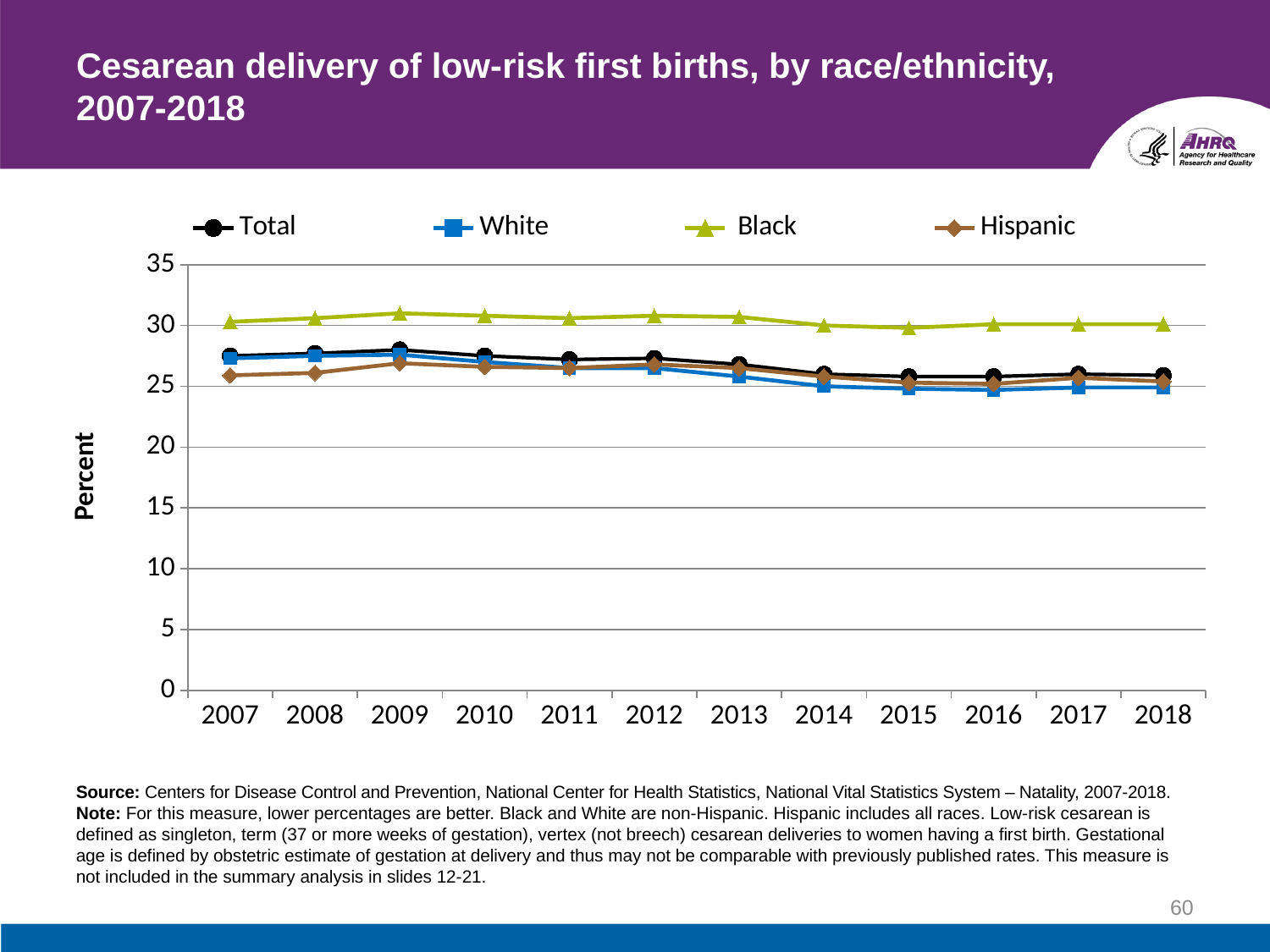
Is the value for Black in 2009 greater or less than 30? greater How many years are plotted along the x axis? 12 Which series has the highest values across all years? Black What kind of chart is shown on the slide? line chart Which series has the lowest value in 2007? Hispanic Is the value for Total in 2009 greater or less than 30? less How many series does the legend list? 4 Is the value for Hispanic in 2007 greater or less than 25? greater What is the label on the y axis? Percent Does the White series rise or fall from 2007 to 2018? fall In 2012, which is larger, the value for Black or the value for Total? Black In 2007, which is larger, the value for Total or the value for Hispanic? Total